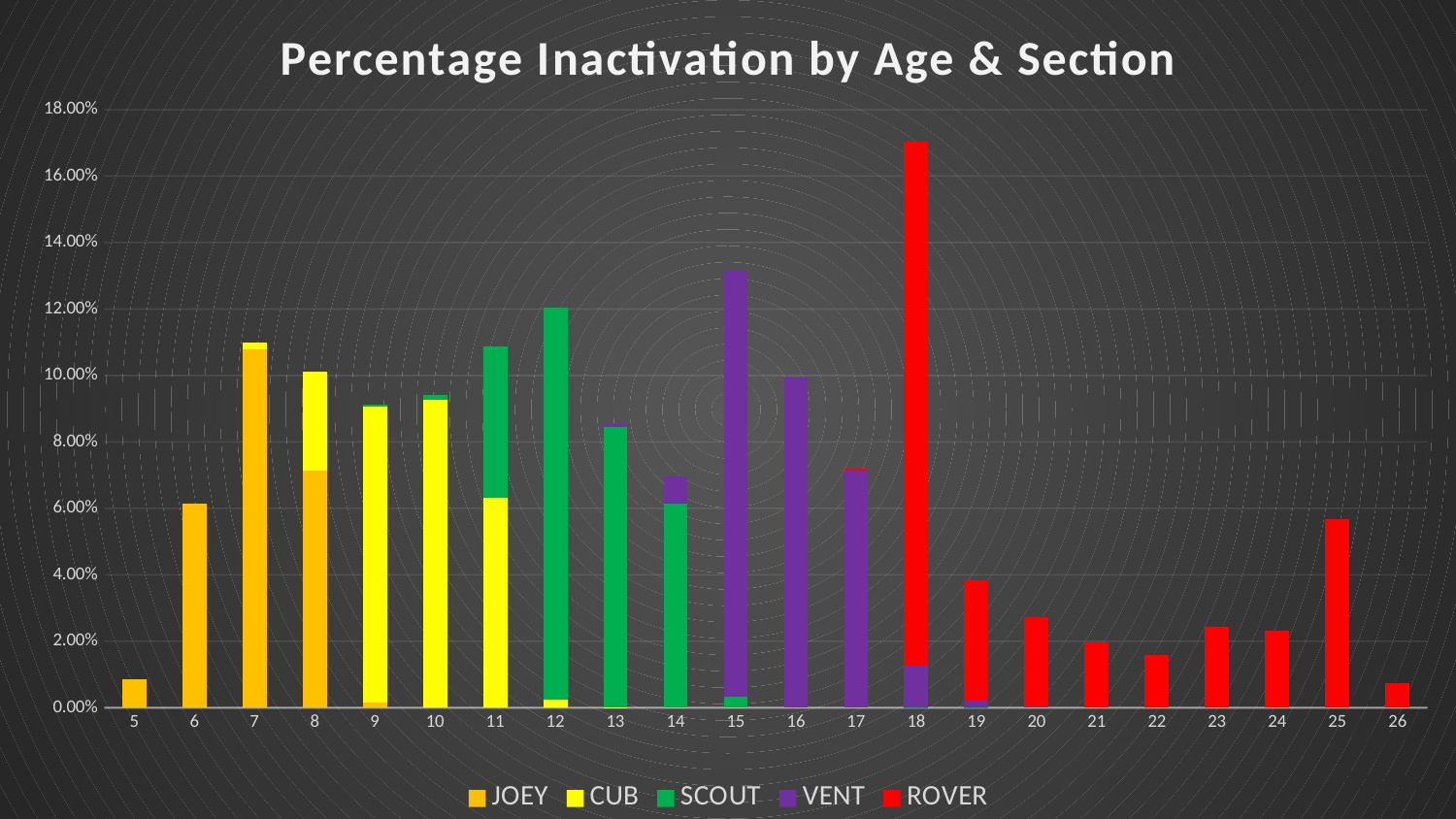
Is the total value for age 15 greater or less than 12.00%? greater How many series does the legend list? 5 Which colour represents the ROVER series in the legend? Red Which age has the highest total percentage inactivation? 18 What is the title of the chart? Percentage Inactivation by Age & Section What type of chart is shown on the slide? Stacked bar chart Is the total value for age 18 greater or less than 16.00%? greater Is the total value for age 25 greater or less than 4.00%? greater Do the total values rise or fall from age 19 to age 22? fall Which has the larger total value, age 15 or age 16? 15 How many age categories are shown on the x axis? 22